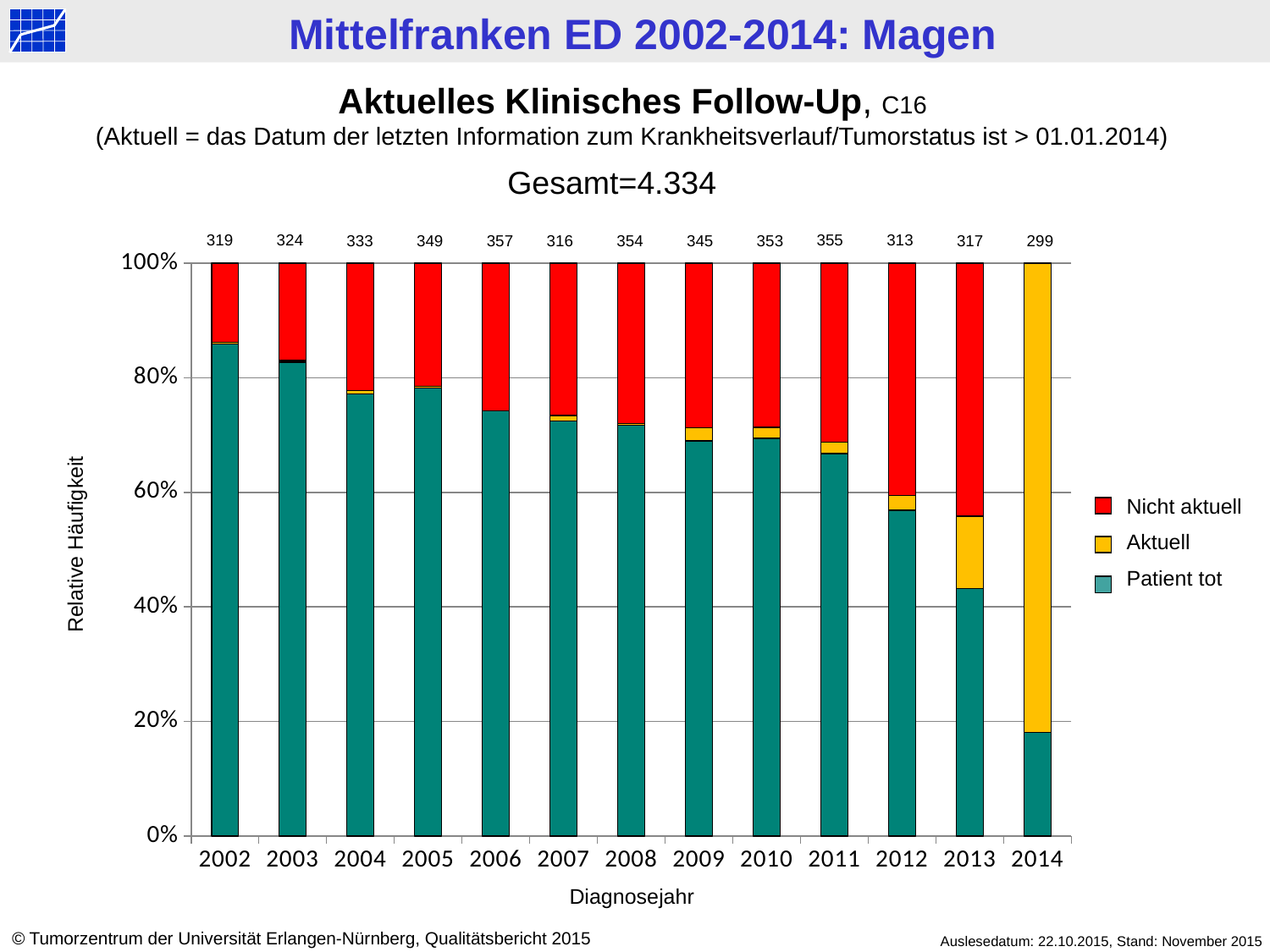
Is the 'Patient tot' share for 2014 greater or less than 20%? less What number is printed above the bar for 2006? 357 Does the 'Patient tot' share rise or fall from 2002 to 2014? fall How many series does the legend list? 3 What is the difference between the numbers printed above the bars for 2002 and 2014? 20 Which year has the lowest number printed above its bar? 2014 What kind of chart is shown on the slide? bar chart What is the title of the x axis? Diagnosejahr What number is printed above the bar for 2014? 299 How many diagnosis years are shown on the x axis? 13 Which year has the highest number printed above its bar? 2006 Which year has the larger number printed above its bar, 2005 or 2009? 2005